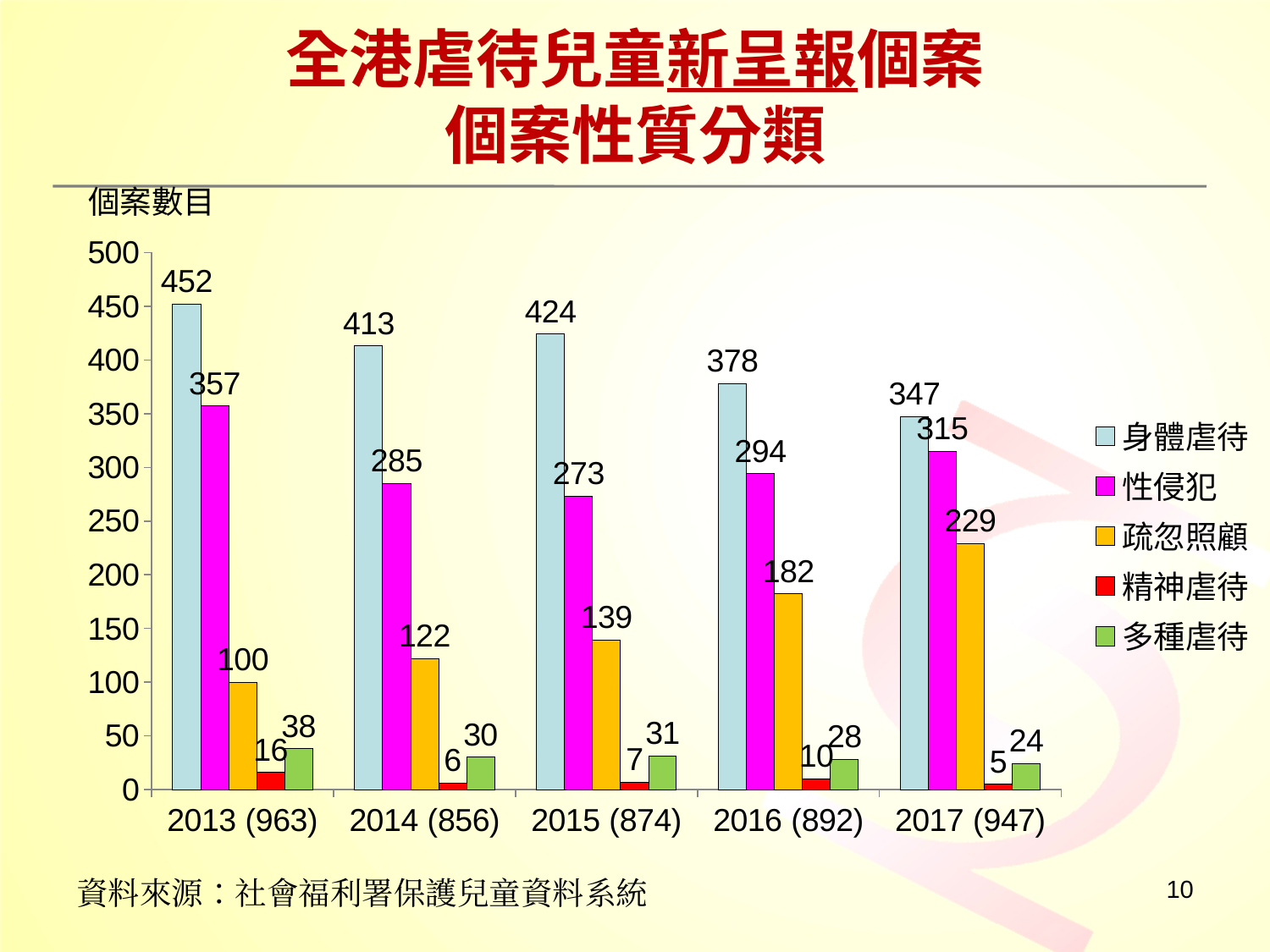
How many series does the legend list? 5 How many year categories are shown on the x axis? 5 What is the value for 身體虐待 in 2013 (963)? 452 Does the value for 疏忽照顧 rise or fall from 2013 (963) to 2017 (947)? rise What is the label of the y axis? 個案數目 What is the value for 疏忽照顧 in 2017 (947)? 229 In which year is the value for 性侵犯 the highest? 2013 (963) What kind of chart is shown on the slide? bar chart What is the value for 精神虐待 in 2015 (874)? 7 What is the difference between 身體虐待 and 性侵犯 in 2017 (947)? 32 Which is larger in 2016 (892): 疏忽照顧 or 多種虐待? 疏忽照顧 In which year is the value for 身體虐待 the lowest? 2017 (947)